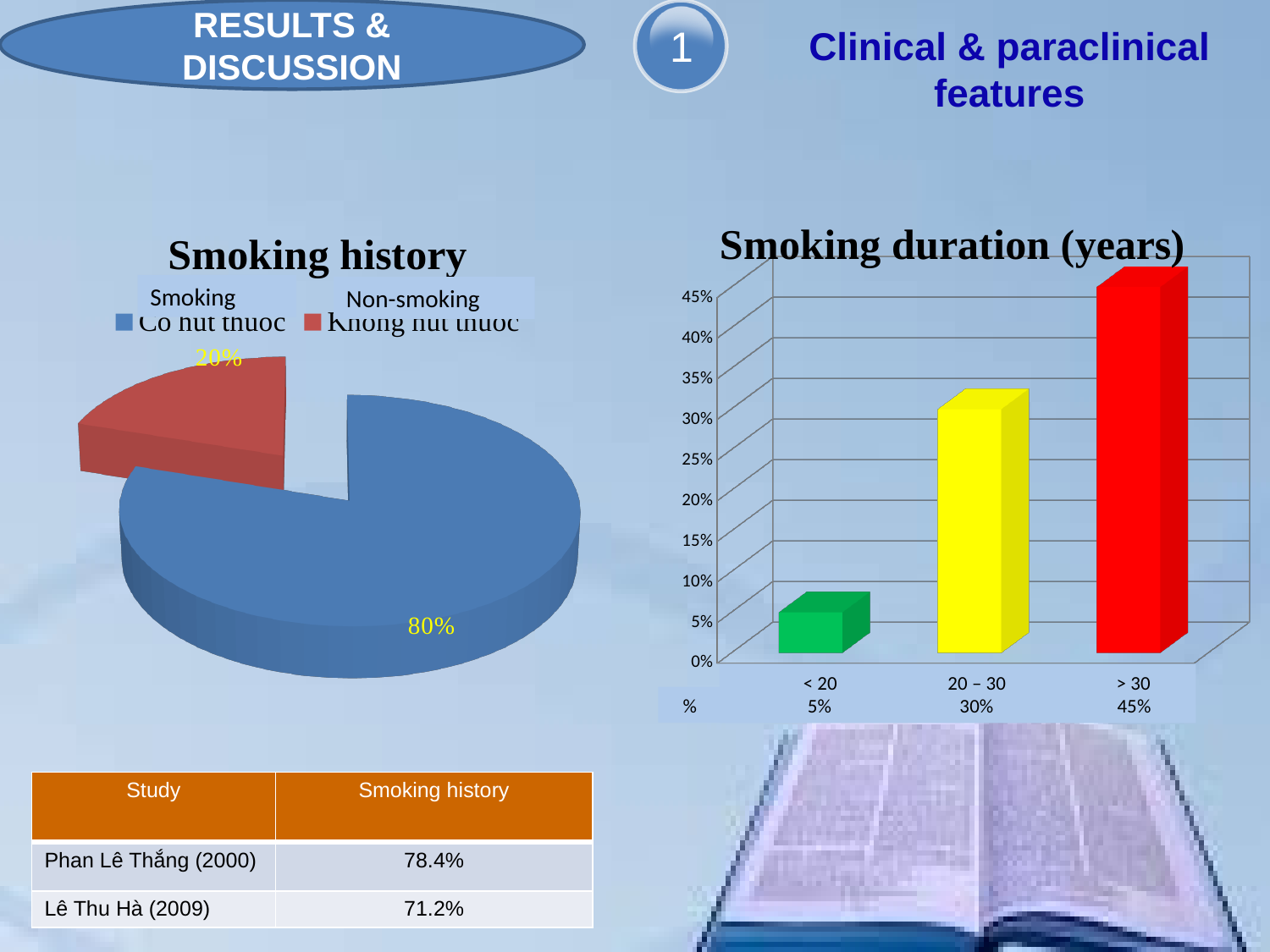
In the Smoking duration (years) chart, which category has the highest value? > 30 In the Smoking duration (years) chart, what is the value for > 30? 45% In the Smoking history chart, which slice is larger, Smoking or Non-smoking? Smoking In the Smoking duration (years) chart, what is the value for < 20? 5% In the Smoking duration (years) chart, what is the difference between the values for > 30 and 20 – 30? 15% In the Smoking history chart, what share of the pie is Non-smoking? 20% In the Smoking history chart, what share of the pie is Smoking? 80% In the Smoking duration (years) chart, what is the value for 20 – 30? 30% What kind of chart is the Smoking history chart? pie chart In the Smoking history chart, what is the difference between the Smoking and Non-smoking shares? 60% In the Smoking duration (years) chart, do the values rise or fall from left to right along the x axis? rise In the Smoking duration (years) chart, which category has the lowest value? < 20